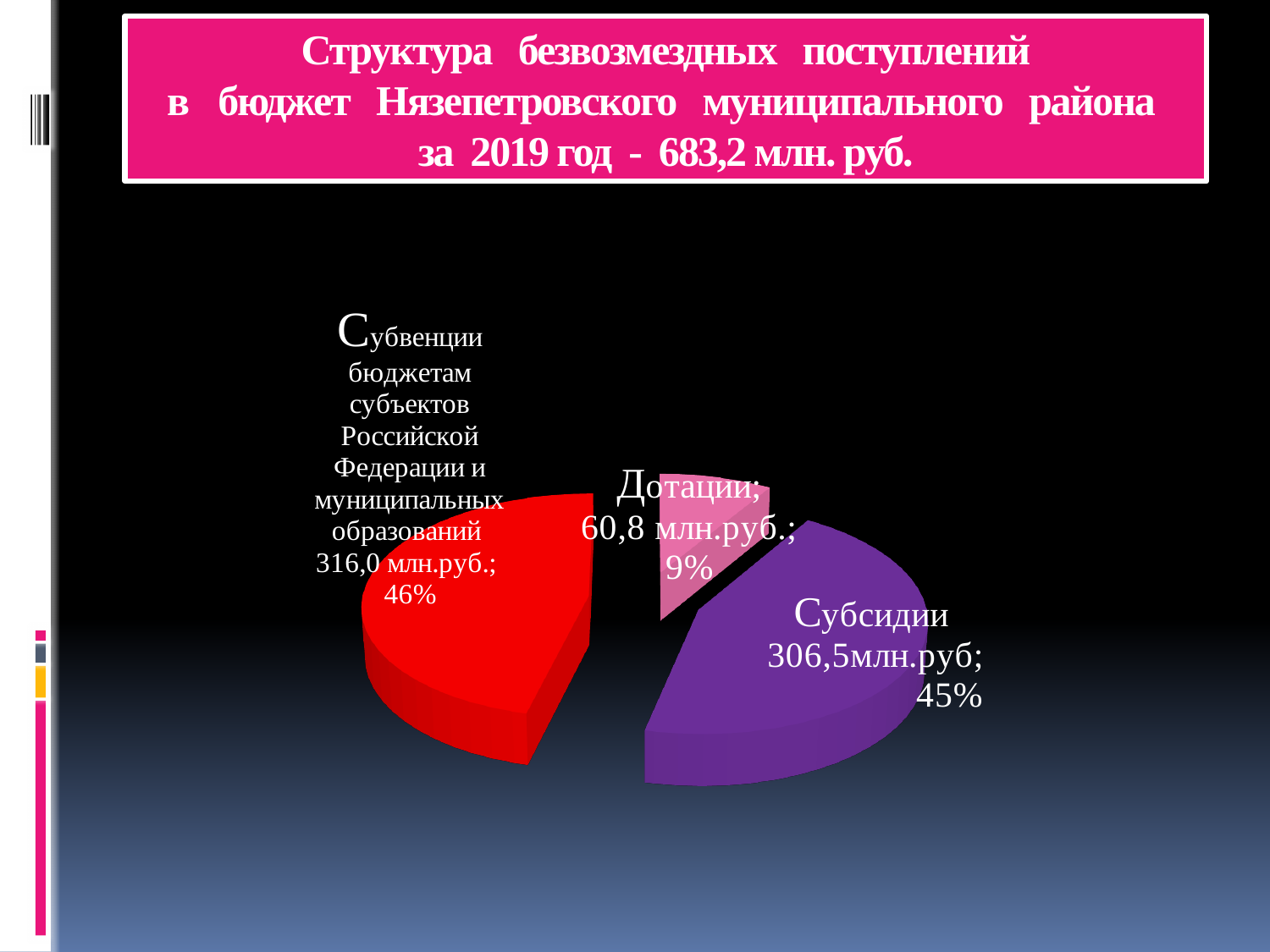
What is the difference between the values for Субвенции and Субсидии? 9,5 млн.руб. What is the value for Дотации? 60,8 млн.руб. What is the value for Субсидии? 306,5 млн.руб What share of the pie does Субвенции represent? 46% What type of chart is shown on the slide? Pie chart What share of the pie does Дотации represent? 9% Which is larger, the value for Субсидии or the value for Дотации? Субсидии Which category has the smallest slice? Дотации What colour is the Субсидии slice? Purple How many slices does the pie chart have? 3 Which category has the largest slice? Субвенции бюджетам субъектов Российской Федерации и муниципальных образований What is the value for Субвенции бюджетам субъектов Российской Федерации и муниципальных образований? 316,0 млн.руб.